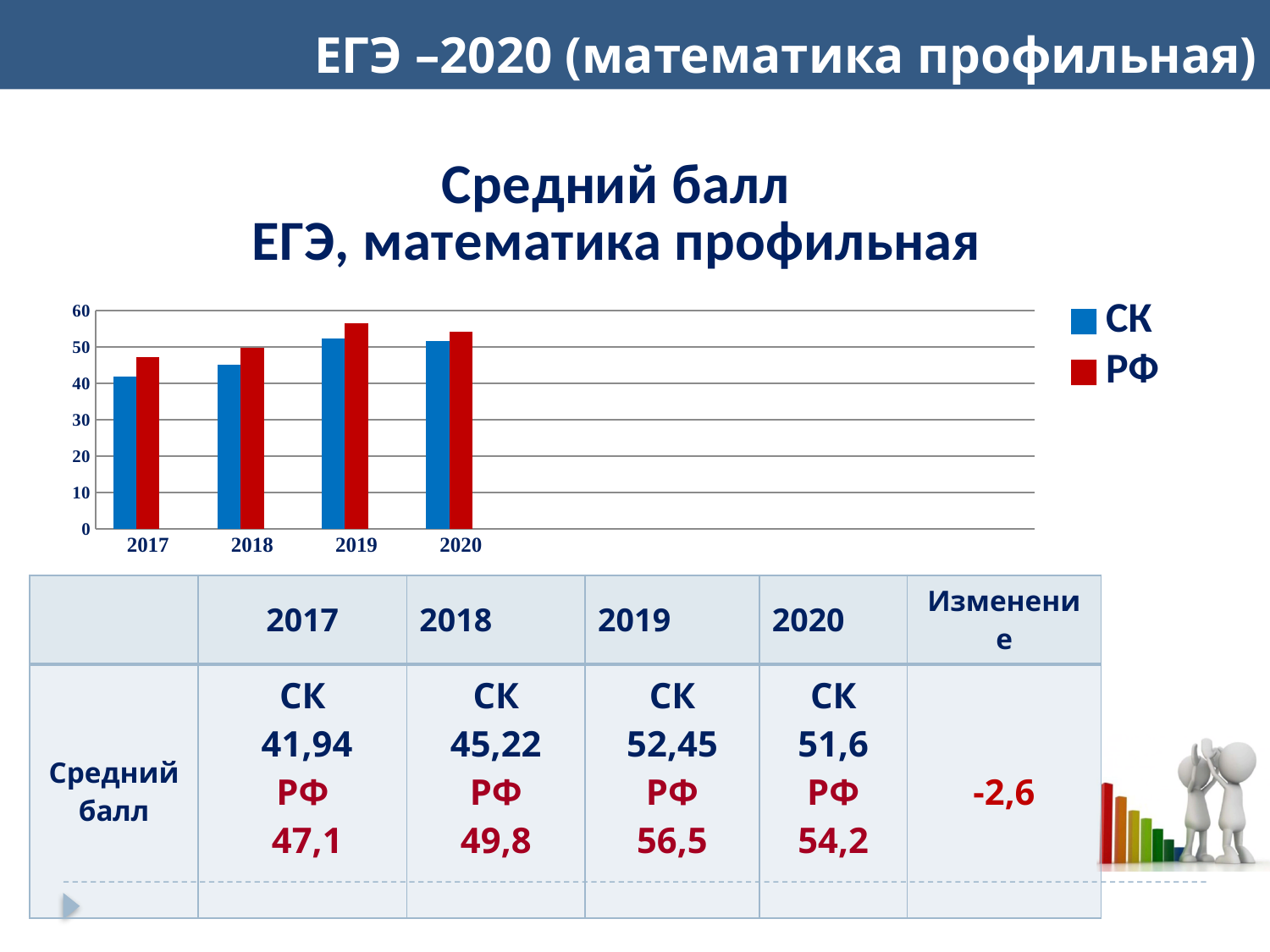
What is the average score for РФ in 2020? 54,2 In which year is the СК bar the lowest? 2017 What is the average score for СК in 2019? 52,45 What colour represents РФ in the chart legend? red Do the СК values rise or fall from 2017 to 2019? rise In 2020, which is larger, the СК value or the РФ value? РФ Is the value for СК in 2017 greater or less than 40? greater What is the difference between the РФ and СК values in 2020? 2,6 How many series does the chart legend list? 2 In which year is the РФ bar the highest? 2019 What kind of chart is shown on the slide? bar chart How many years are shown on the x axis of the chart? 4